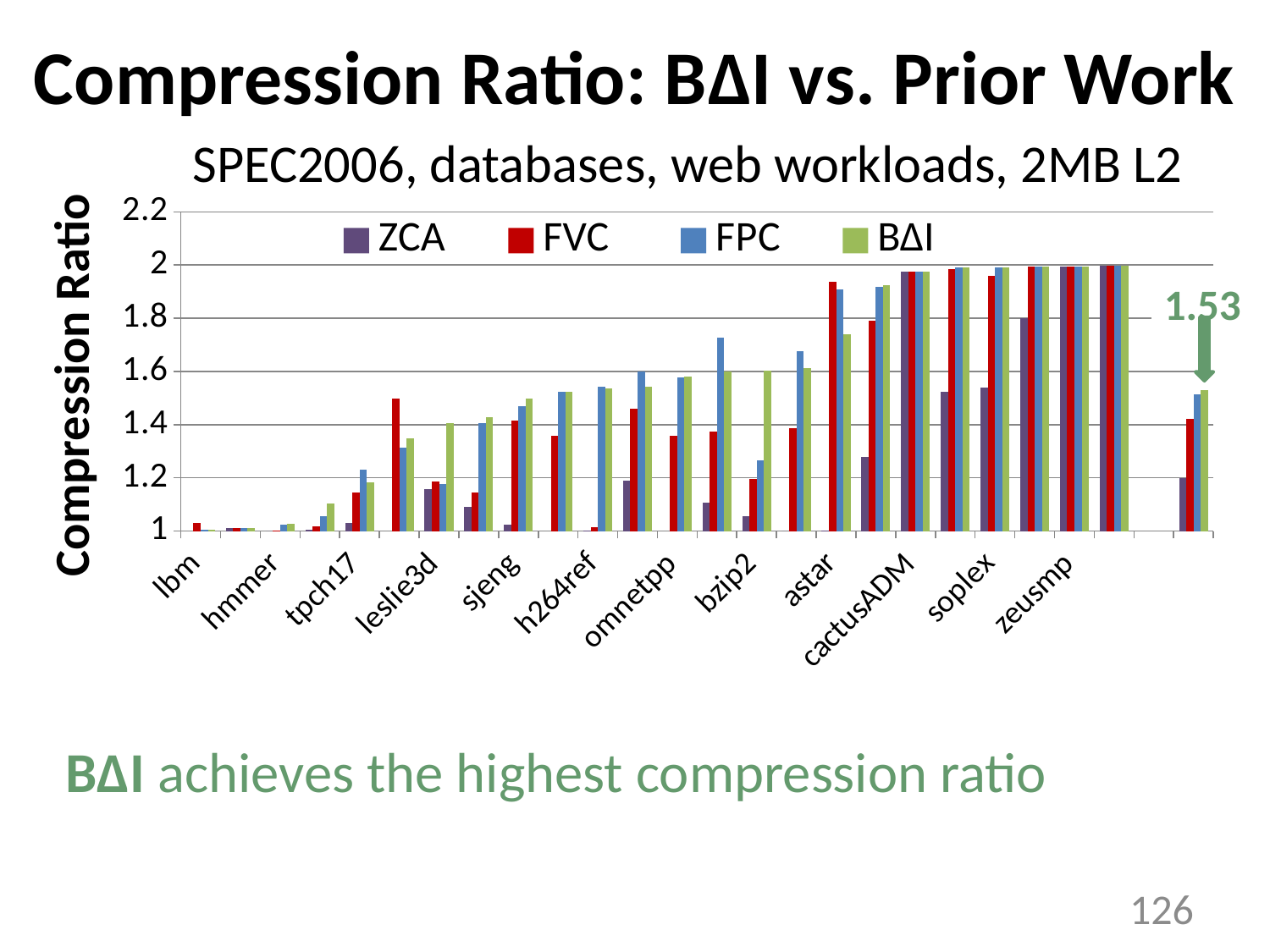
What is the highest tick value shown on the vertical axis? 2.2 Is the FVC value for lbm greater or less than 1.2? less What kind of chart is shown on the slide? bar chart In the rightmost group of bars, is the value for ZCA greater or less than 1.4? less In the rightmost group of bars, is the value for BΔI larger or smaller than the value for ZCA? larger Do the BΔI compression ratios generally rise or fall from lbm to zeusmp along the x axis? rise Which series are listed in the chart legend? ZCA, FVC, FPC, BΔI What value is printed as a data label above the rightmost group of bars? 1.53 What is the title of the vertical axis? Compression Ratio Is the BΔI value for zeusmp greater or less than 1.8? greater How many series does the chart legend list? 4 Which series has the lowest value in the rightmost group of bars? ZCA